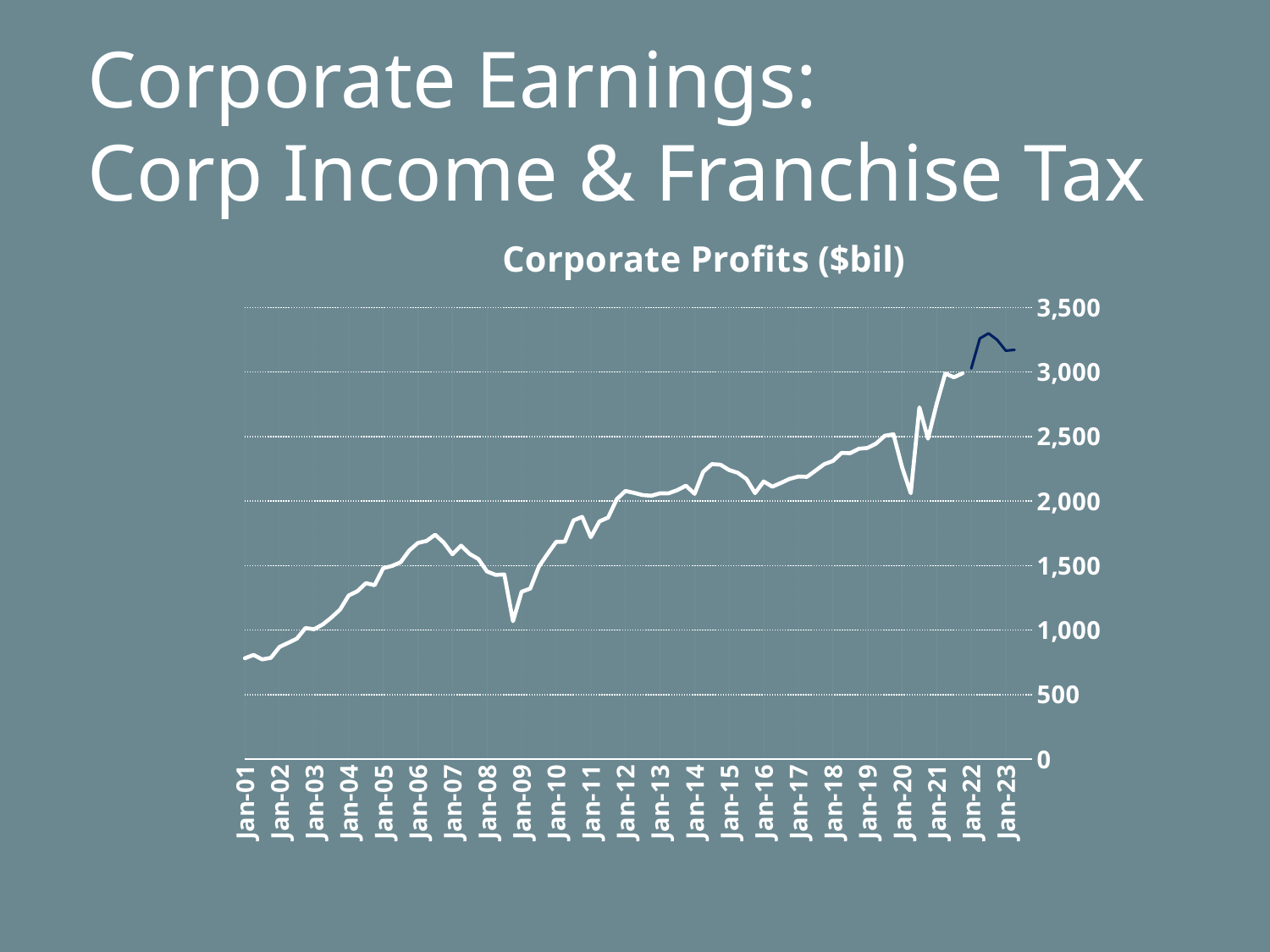
Which is larger, the value at Jan-01 or the value at Jan-23? Jan-23 How many date labels are shown on the x axis? 23 At which labelled date is the line at its lowest point? Jan-01 Is the value for Jan-01 greater or less than 1,000? less Overall, do corporate profits rise or fall from Jan-01 to Jan-23? Rise Is the value for Jan-23 greater or less than 3,000? greater What kind of chart is shown on the slide? Line chart What is the highest value shown on the y axis? 3,500 Is the value for Jan-04 greater or less than 1,000? greater What is the title of the chart? Corporate Profits ($bil)